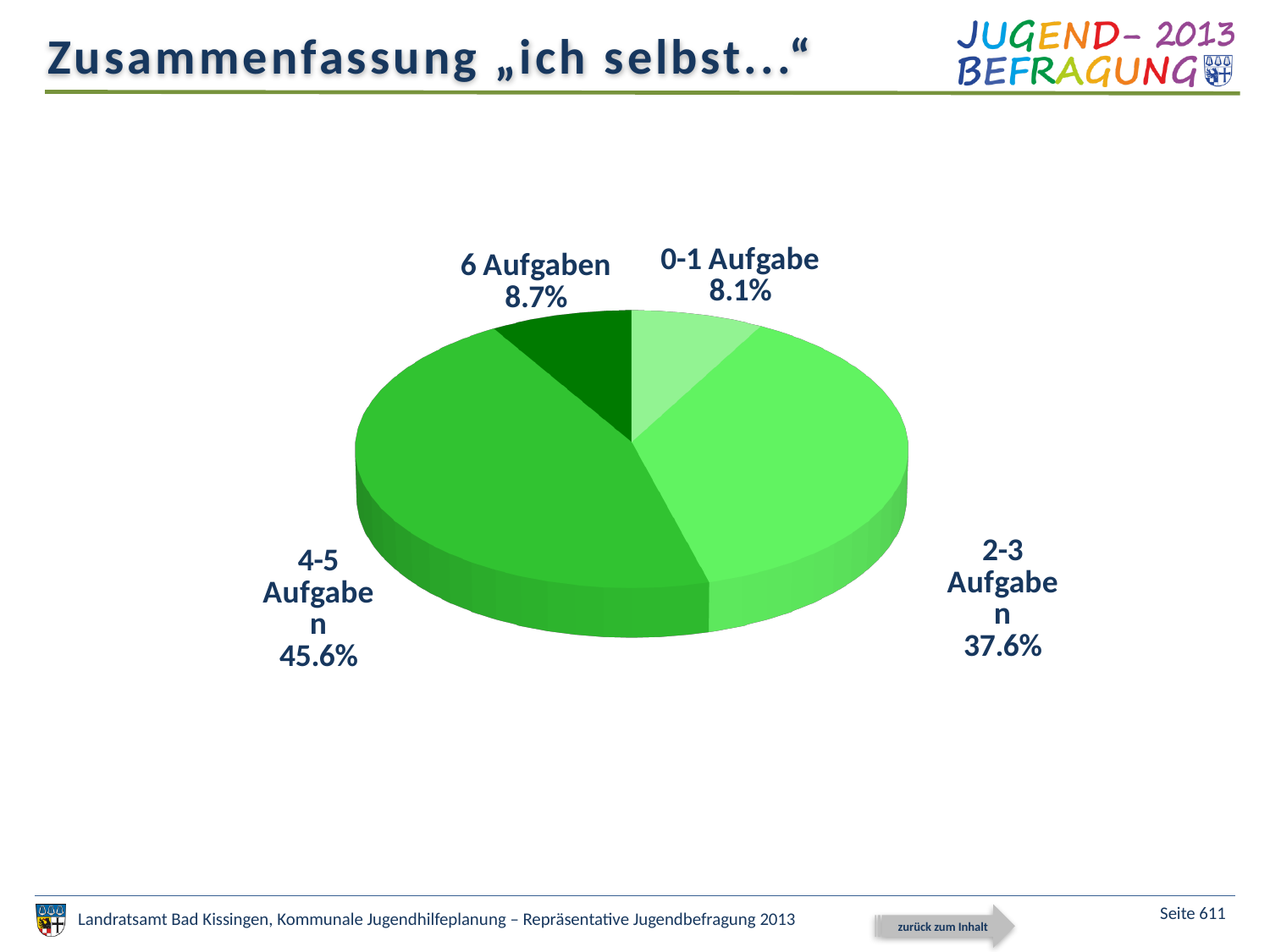
What is the difference in percentage points between the "4-5 Aufgaben" and "2-3 Aufgaben" slices? 8.0 Which category has the smallest slice of the pie? 0-1 Aufgabe What is the value shown for "0-1 Aufgabe"? 8.1% Which category has the largest slice of the pie? 4-5 Aufgaben What is the difference in percentage points between the "6 Aufgaben" and "0-1 Aufgabe" slices? 0.6 What is the value shown for "2-3 Aufgaben"? 37.6% What is the title of the slide containing the pie chart? Zusammenfassung „ich selbst…“ How many slices does the pie chart have? 4 What is the value shown for "6 Aufgaben"? 8.7% Which is larger, the share for "2-3 Aufgaben" or the share for "4-5 Aufgaben"? 4-5 Aufgaben What share of the pie does the "4-5 Aufgaben" slice represent? 45.6% What kind of chart is shown on the slide? pie chart